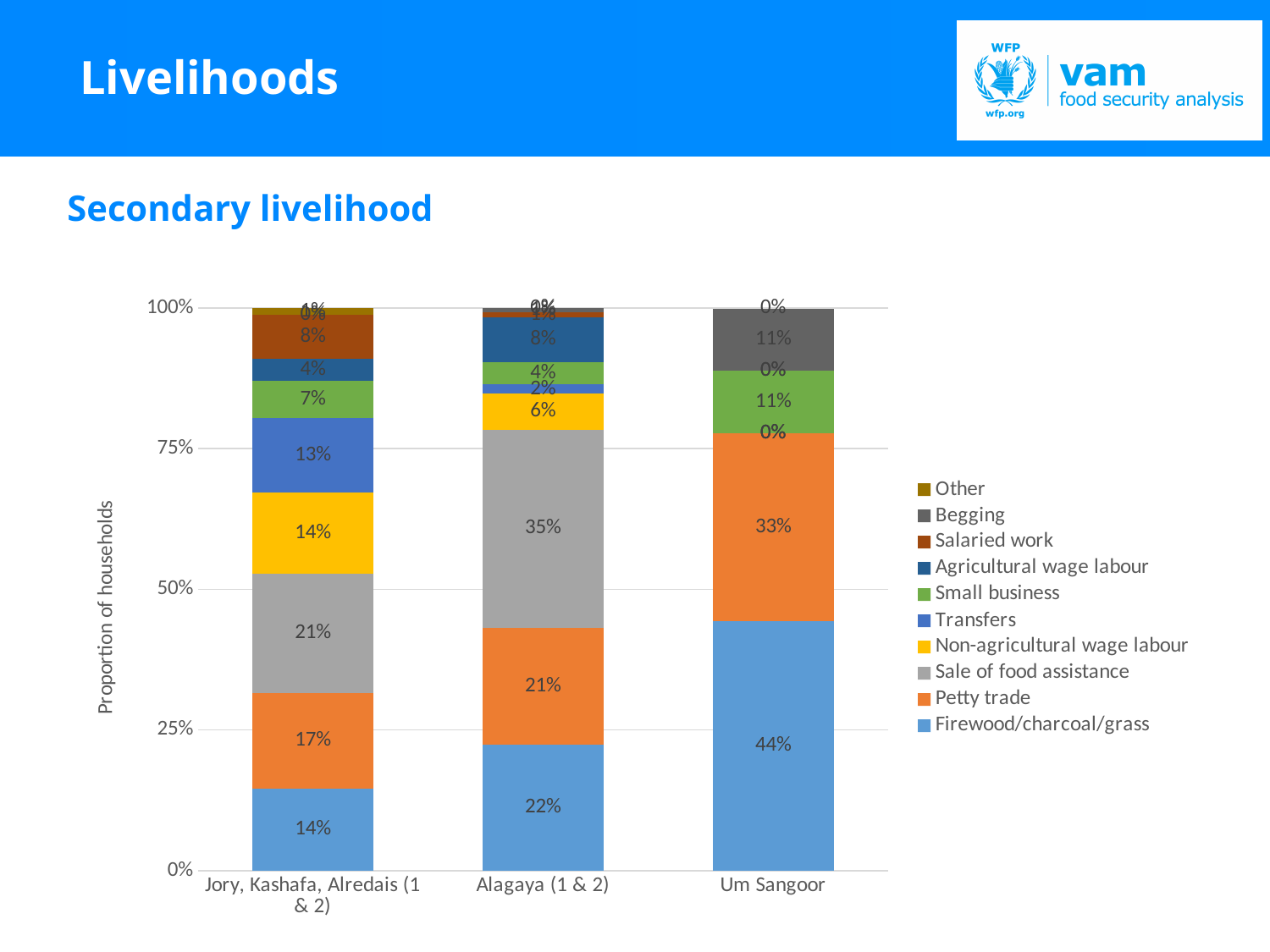
What is the value for Petty trade in Um Sangoor? 33% How many series does the legend list? 10 Which location has the highest value for Firewood/charcoal/grass? Um Sangoor Which location has the lowest value for Firewood/charcoal/grass? Jory, Kashafa, Alredais (1 & 2) Which is larger: Petty trade in Alagaya (1 & 2) or Petty trade in Jory, Kashafa, Alredais (1 & 2)? Alagaya (1 & 2) What is the difference between the Sale of food assistance values for Alagaya (1 & 2) and Jory, Kashafa, Alredais (1 & 2)? 14% What is the value for Transfers in Jory, Kashafa, Alredais (1 & 2)? 13% What is the value for Sale of food assistance in Alagaya (1 & 2)? 35% What is the value for Firewood/charcoal/grass in Um Sangoor? 44% What is the label of the y axis? Proportion of households How many location categories are shown on the x axis? 3 What type of chart is shown on the slide? stacked bar chart